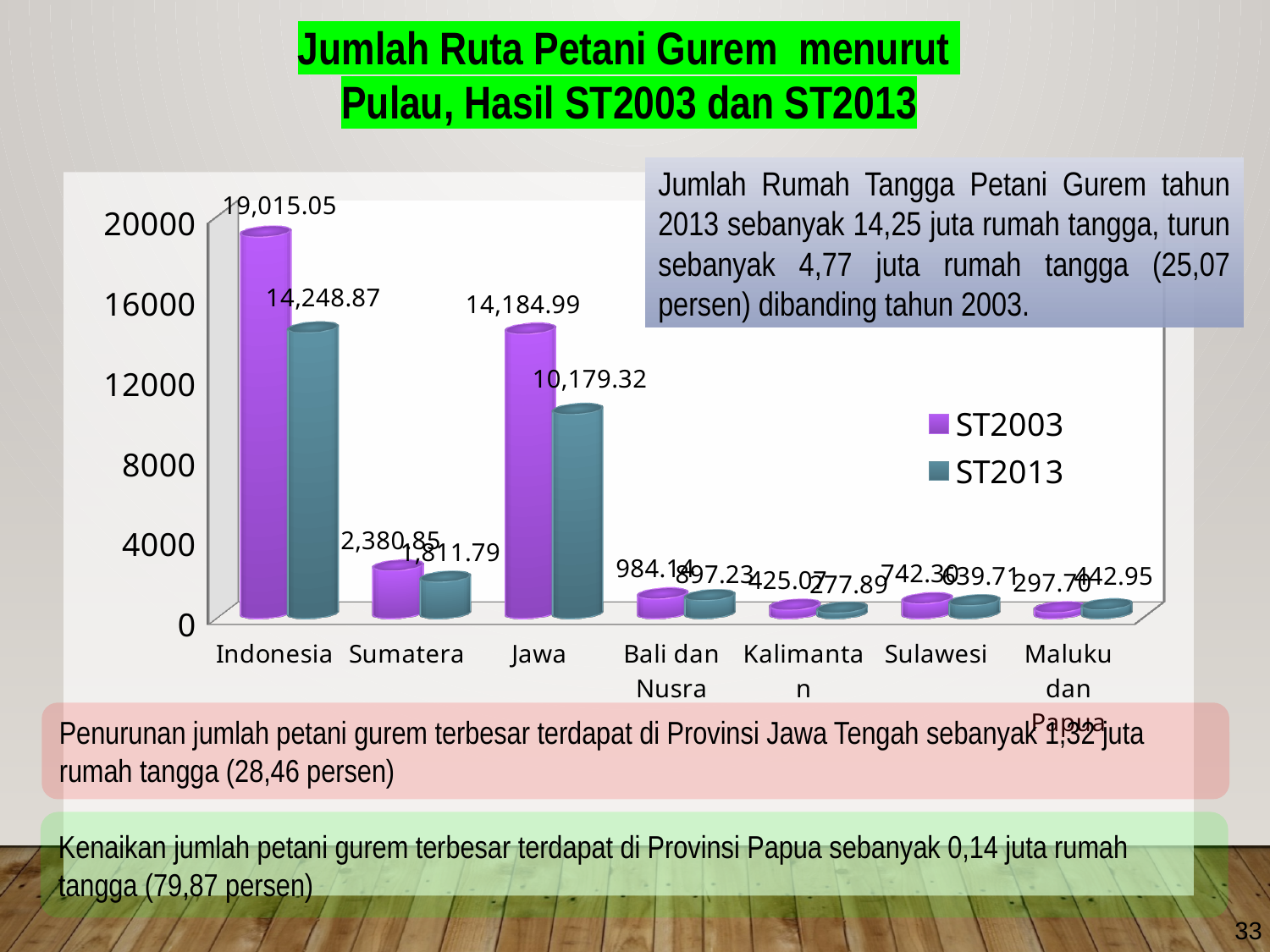
For Sumatera, which series has the larger value, ST2003 or ST2013? ST2003 What is the ST2003 value for Sumatera? 2,380.85 Which category has the lowest ST2013 value? Kalimantan Which category has the highest ST2013 value? Indonesia What kind of chart is shown on the slide? bar chart What is the difference between the ST2003 and ST2013 values for Indonesia? 4,766.18 What is the difference between the ST2003 and ST2013 values for Jawa? 4,005.67 How many series does the legend list? 2 How many categories are shown on the x axis? 7 What is the ST2013 value for Jawa? 10,179.32 What is the ST2003 value for Indonesia? 19,015.05 Is the ST2013 value for Jawa greater or less than 12000? less